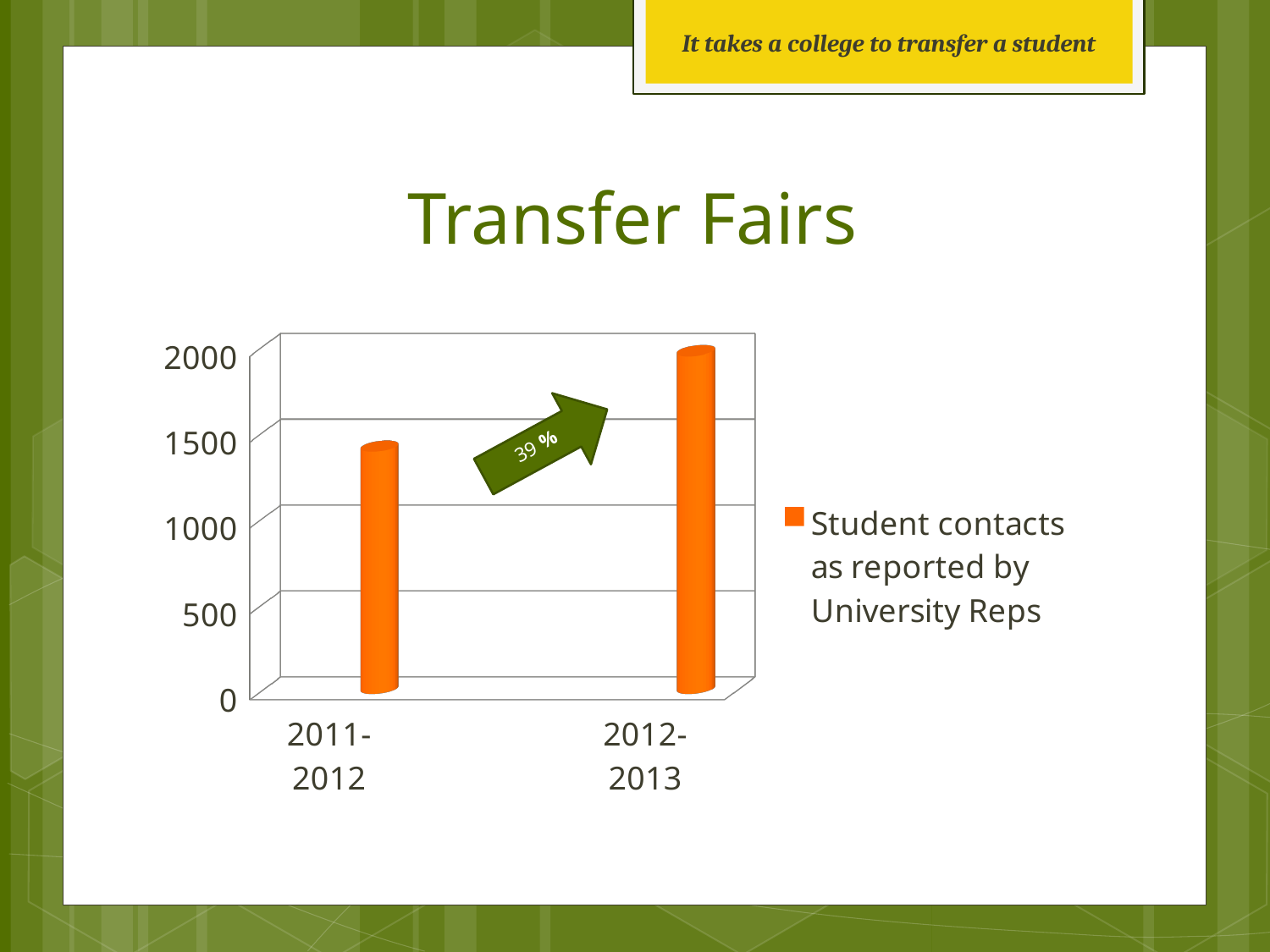
Is the value for 2012-2013 greater or less than 1500? greater What is the title of the chart on the slide? Transfer Fairs Do the values rise or fall from 2011-2012 to 2012-2013? rise How many series does the chart legend list? 1 How many categories are shown on the x axis of the chart? 2 What percentage is written on the arrow between the two bars? 39 % Is the value for 2011-2012 greater or less than 1000? greater Which is larger, the value for 2011-2012 or the value for 2012-2013? 2012-2013 Which category has the lowest value in the chart? 2011-2012 Is the value for 2011-2012 greater or less than 1500? less Which category has the highest value in the chart? 2012-2013 What kind of chart is shown on the slide? bar chart